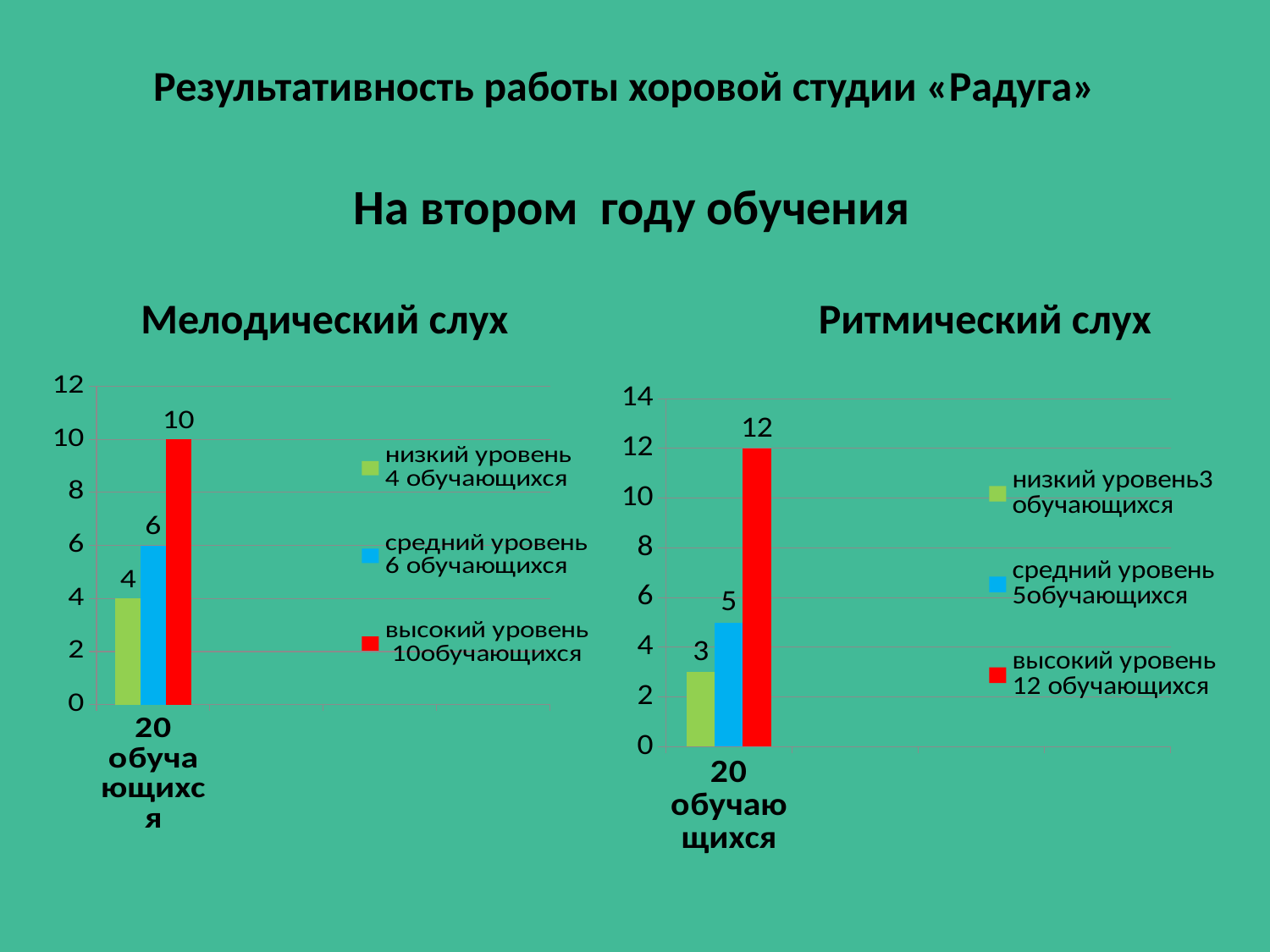
In the «Ритмический слух» chart, what is the difference between the «высокий уровень» and «низкий уровень» values? 9 Which is larger: «средний уровень» in the «Мелодический слух» chart or «средний уровень» in the «Ритмический слух» chart? Мелодический слух In the «Мелодический слух» chart, what is the value for «высокий уровень»? 10 How many series does the legend of the «Ритмический слух» chart list? 3 In the «Ритмический слух» chart, what is the value for «средний уровень»? 5 What kind of chart is the «Мелодический слух» chart? bar chart In the «Ритмический слух» chart, what is the value for «высокий уровень»? 12 In the «Мелодический слух» chart, what is the value for «низкий уровень»? 4 In the «Ритмический слух» chart, which series has the lowest value? низкий уровень In the «Ритмический слух» chart, what colour is the bar for «высокий уровень»? red In the «Мелодический слух» chart, what is the difference between the «высокий уровень» and «средний уровень» values? 4 In the «Мелодический слух» chart, which series has the highest value? высокий уровень